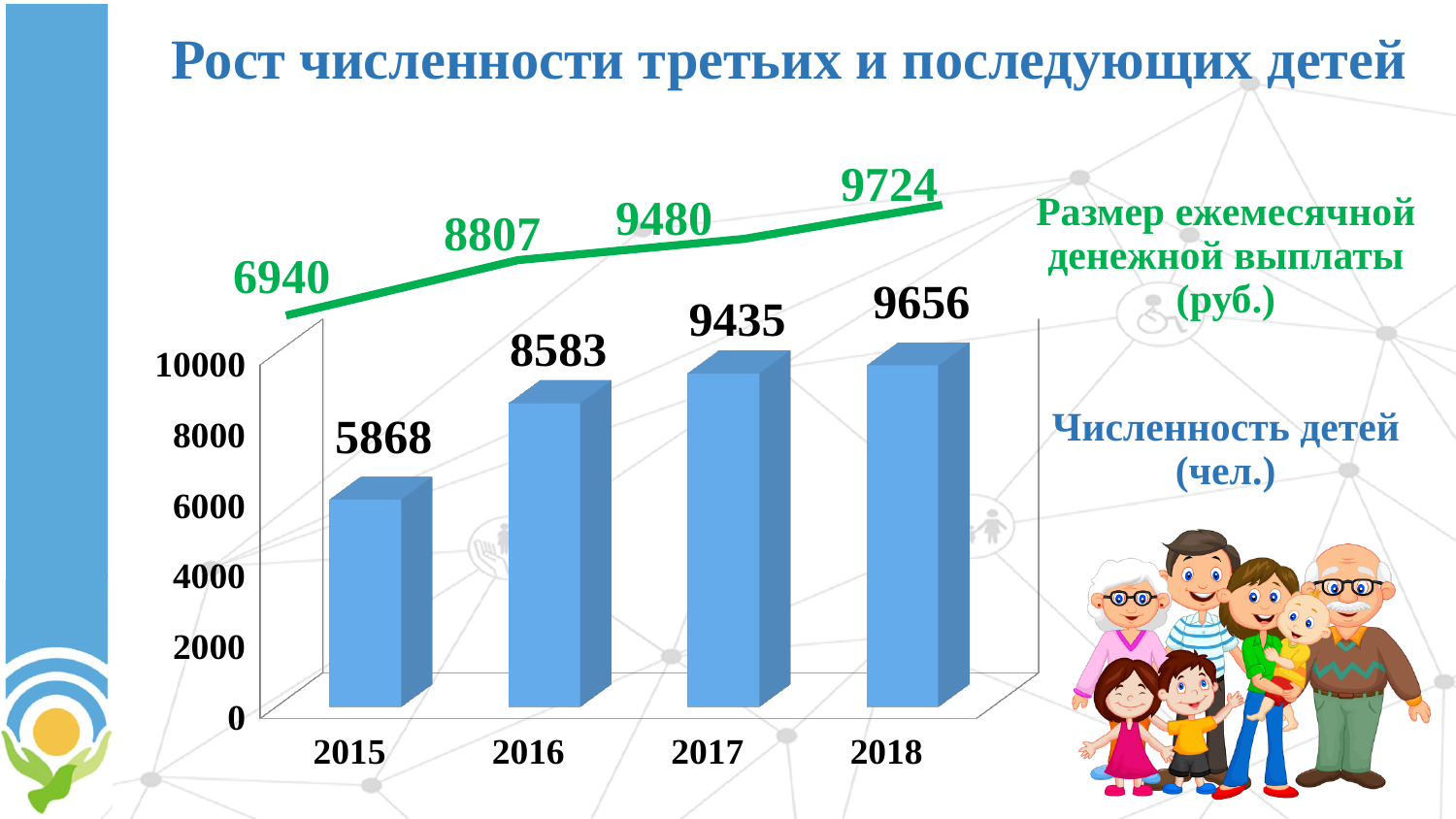
Which year has the lowest monthly payment amount? 2015 What is the number of children (Численность детей) in 2015? 5868 Which is larger: the number of children in 2017 or in 2016? 2017 How many years are shown on the x axis? 4 What is the number of children (Численность детей) in 2018? 9656 What is the difference in the number of children between 2016 and 2015? 2715 Does the number of children rise or fall from 2015 to 2018? rise What is the monthly payment amount (Размер ежемесячной денежной выплаты) in 2016? 8807 Which year has the highest number of children? 2018 What is the title of the chart? Рост численности третьих и последующих детей What is the monthly payment amount (Размер ежемесячной денежной выплаты) in 2018? 9724 What is the difference in the monthly payment amount between 2018 and 2017? 244